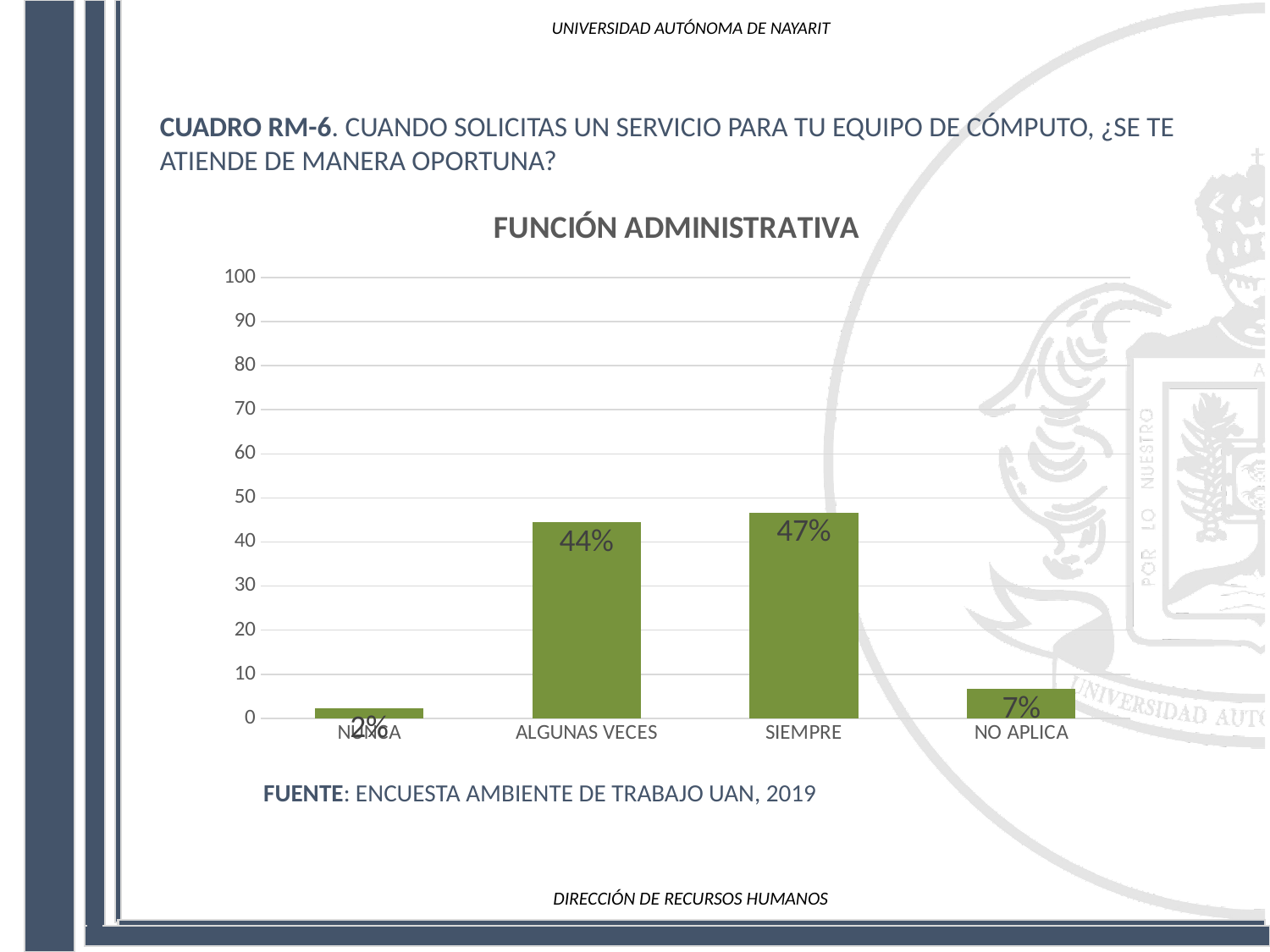
What is the value for NO APLICA? 7% Is the value for ALGUNAS VECES greater or less than 50? less Which category has the lowest value? NUNCA What is the difference between the values for SIEMPRE and ALGUNAS VECES? 3% What is the value for SIEMPRE? 47% How many categories are shown on the x axis? 4 What is the value for NUNCA? 2% Which category has the highest value? SIEMPRE What is the value for ALGUNAS VECES? 44% Which is larger, the value for NO APLICA or the value for NUNCA? NO APLICA What is the difference between the values for NO APLICA and NUNCA? 5% What kind of chart is shown on the slide? bar chart